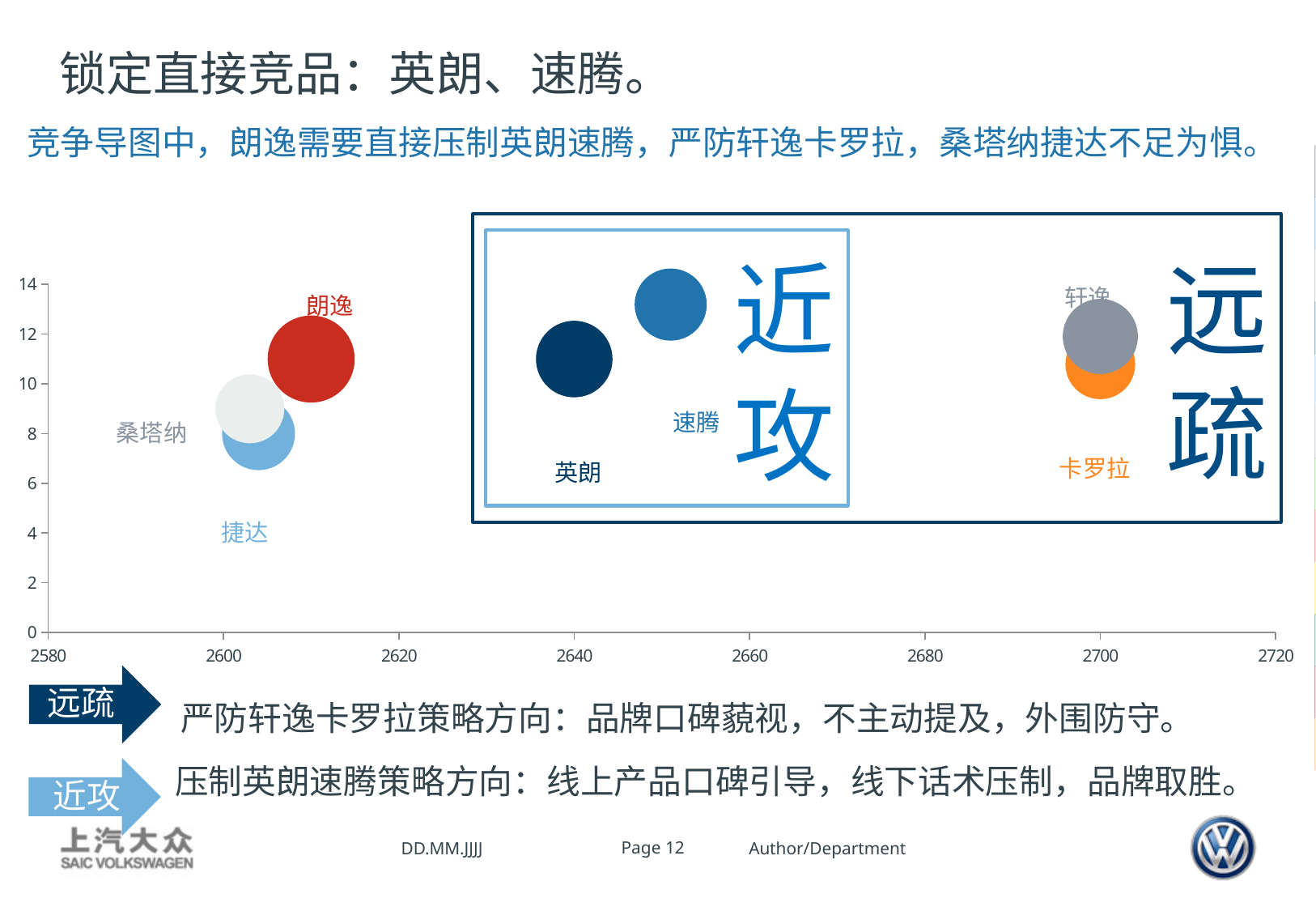
Is the horizontal-axis value for 桑塔纳 greater or less than 2620? less Which bubble is positioned highest on the vertical axis? 速腾 Is the vertical-axis value for 捷达 greater or less than 10? less How many labelled bubbles (car models) are plotted on the chart? 7 Which bubble is positioned lowest on the vertical axis? 捷达 Is the vertical-axis value for 速腾 greater or less than 10? greater What colour is the bubble for 朗逸? red What kind of chart is shown on the slide? bubble chart Which has the larger horizontal-axis value, 朗逸 or 轩逸? 轩逸